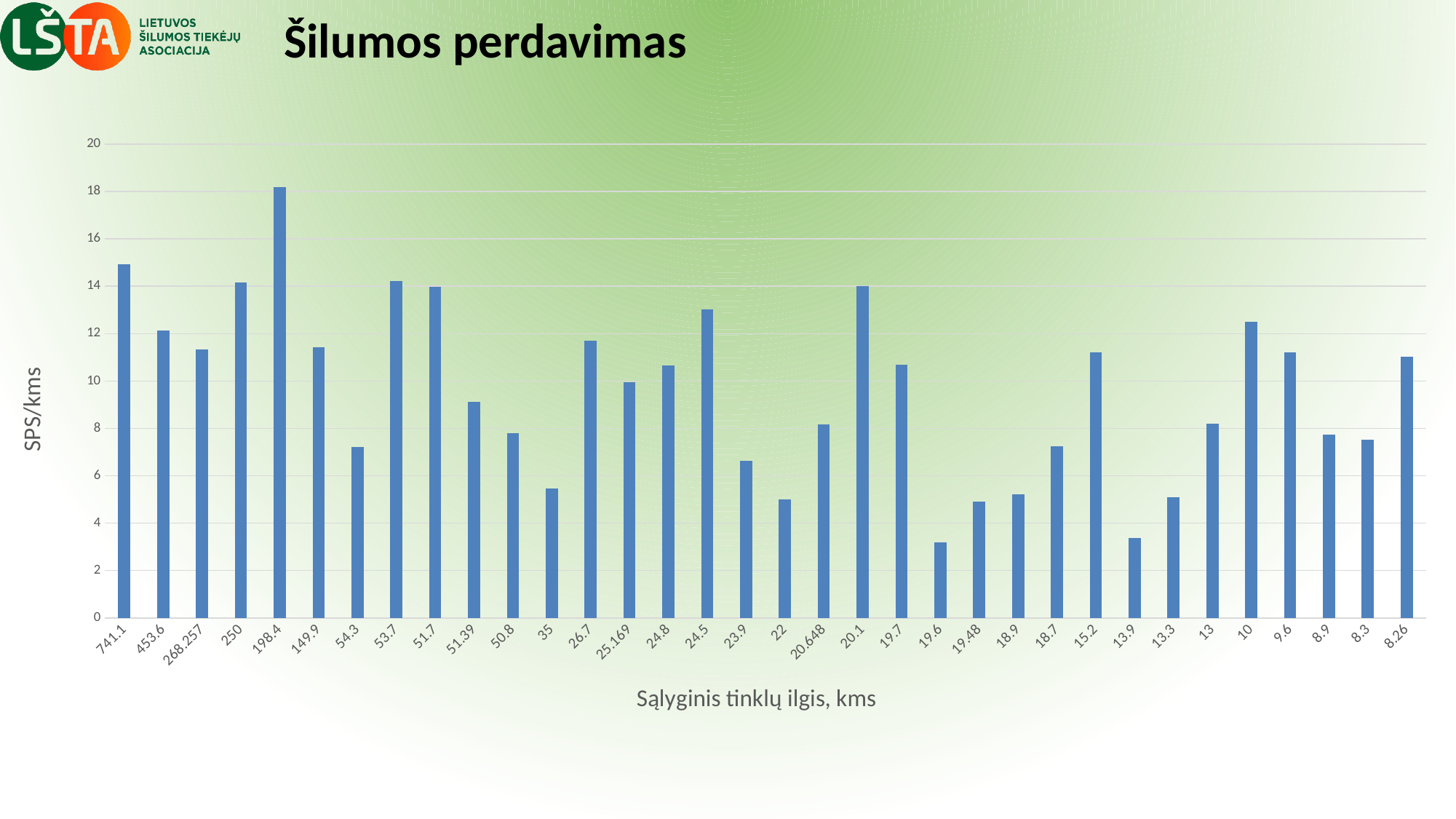
What is the title of the chart? Šilumos perdavimas Which has the larger value, 198.4 or 741.1? 198.4 Is the value for 54.3 greater or less than 8? less What is the label of the vertical axis? SPS/kms What kind of chart is shown on the slide? bar chart Is the value for 35 greater or less than 6? less Is the value for 741.1 greater or less than 14? greater How many bars (categories) are plotted in the chart? 34 Which category has the highest bar? 198.4 Which has the larger value, 35 or 26.7? 26.7